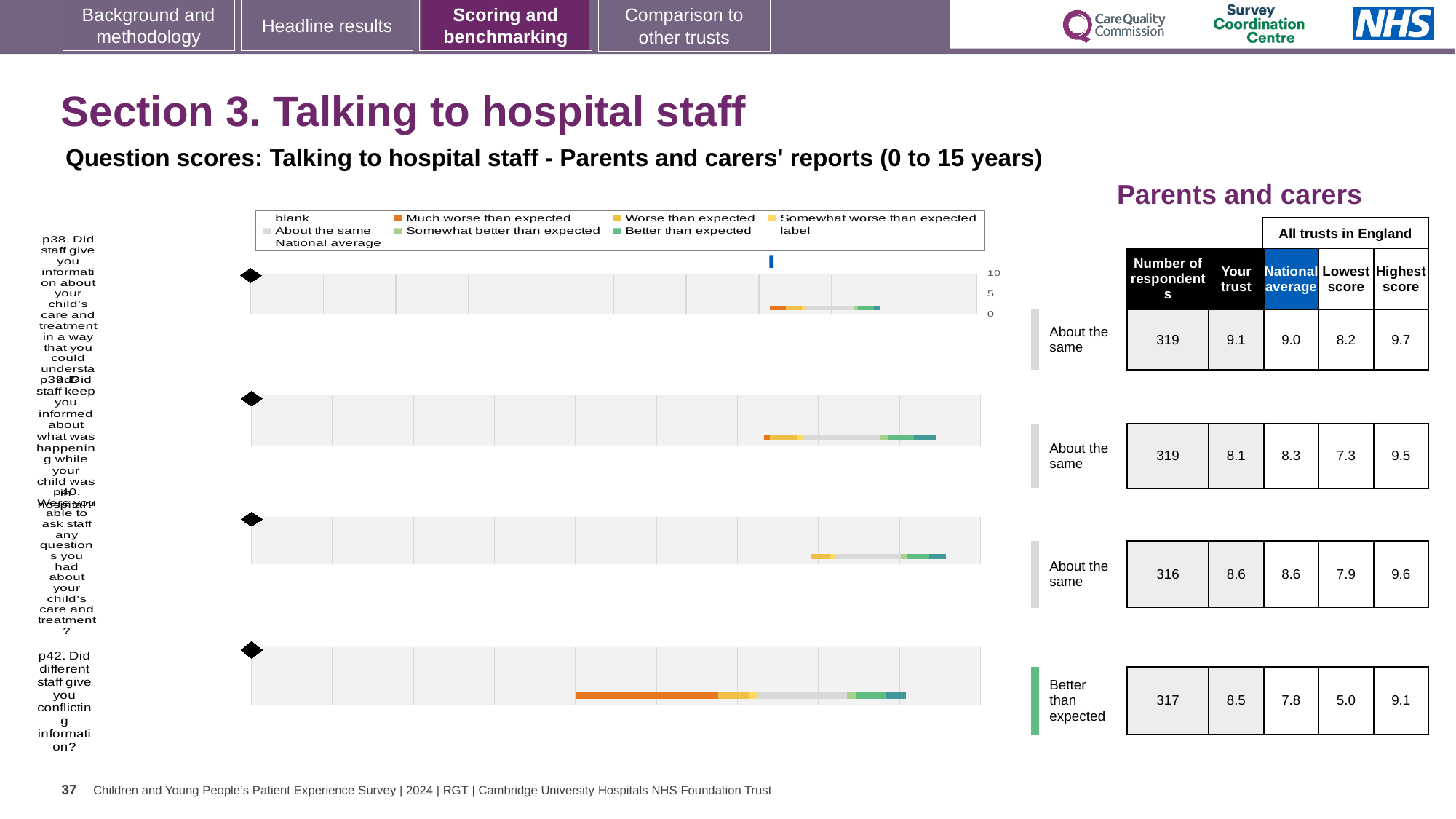
Which question has the lowest 'Your trust' score on this slide? p39 For p39, which is larger: the 'Your trust' score or the national average? National average Which question has the highest 'Your trust' score on this slide? p38 For p38 (Did staff give you information about your child's care and treatment in a way that you could understand?), what is the 'Your trust' score? 9.1 For p39 (Did staff keep you informed about what was happening while your child was in hospital?), what is the national average score? 8.3 For p42 (Did different staff give you conflicting information?), what is the lowest score among all trusts in England? 5.0 For p42, what is the difference between the 'Your trust' score and the national average? 0.7 What kind of chart is used to show the benchmark ranges for each question on this slide? bar chart Which question on this slide is rated 'Better than expected'? p42 How many survey questions (charts) are shown on this slide? 4 How many respondents answered p40 (Were you able to ask staff any questions you had about your child's care and treatment?)? 316 In the legend, what colour represents 'Much worse than expected'? Orange